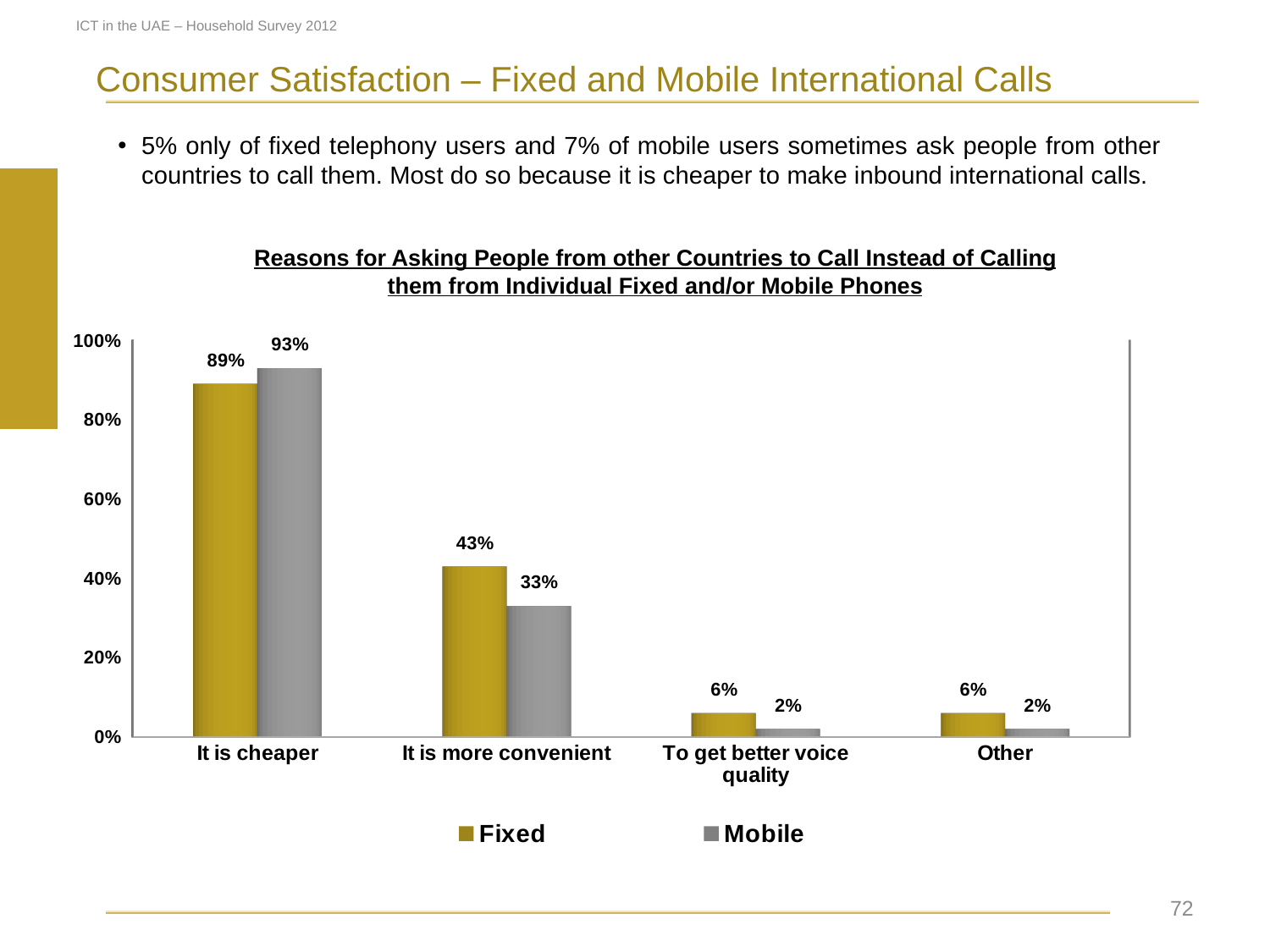
Which category has the highest Mobile value? It is cheaper What kind of chart is shown on the slide? Bar chart What is the Fixed value for "It is cheaper"? 89% How many series does the legend list? 2 For "It is cheaper", which is larger, the Fixed or the Mobile value? Mobile What is the Mobile value for "To get better voice quality"? 2% What colour are the Fixed bars? Gold How many categories are shown on the x axis? 4 Is the Fixed value for "It is more convenient" greater or less than 40%? greater Which category has the lowest Fixed value? To get better voice quality and Other (both 6%) What is the difference between the Fixed and Mobile values for "It is more convenient"? 10% What is the Mobile value for "It is more convenient"? 33%